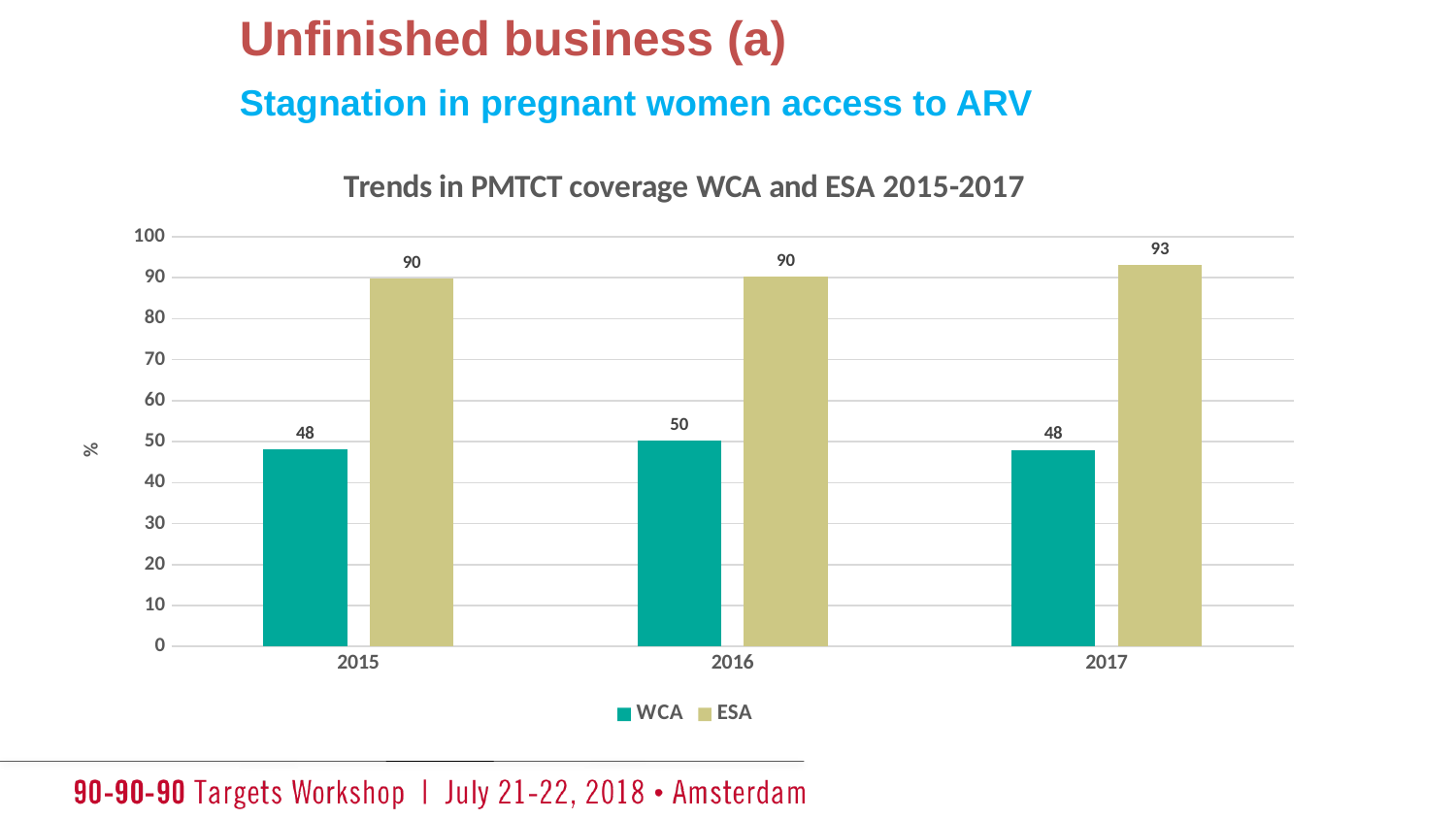
What is the difference between the ESA and WCA values in 2017? 45 What is the difference between the ESA and WCA values in 2015? 42 In which year is the WCA value highest? 2016 What is the ESA value for 2017? 93 What kind of chart is shown on the slide? Bar chart How many series does the legend list? 2 What is the title of the chart? Trends in PMTCT coverage WCA and ESA 2015-2017 What is the WCA value for 2015? 48 Which is larger in 2016, the WCA value or the ESA value? ESA How many years are shown on the x axis? 3 What is the WCA value for 2016? 50 In which year is the ESA value highest? 2017